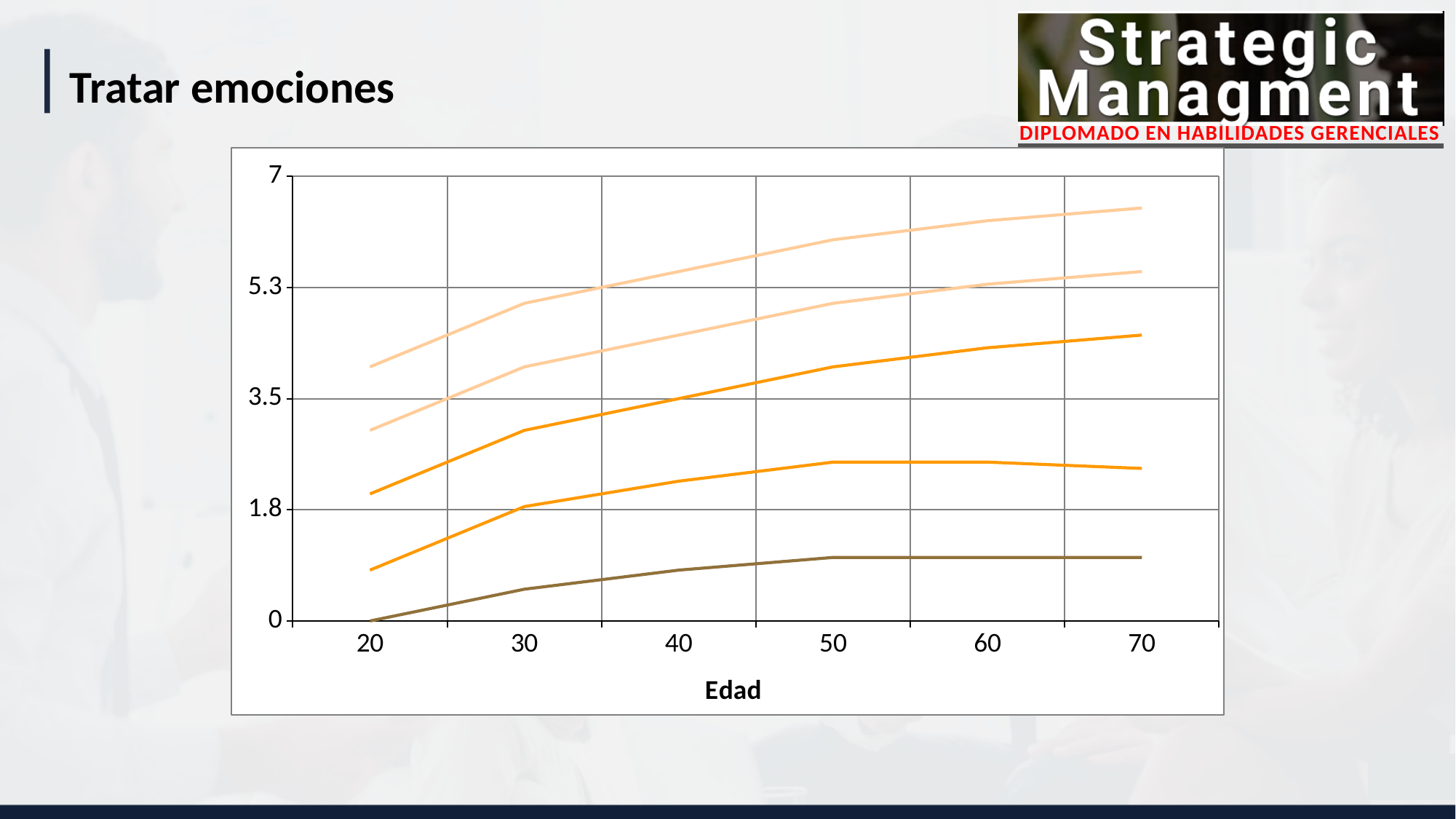
What is the title of the x axis of the chart? Edad Is the value of the second line from the top at age 20 greater or less than 3.5? less What is the highest value shown on the y axis of the chart? 7 At age 70, which is larger: the value of the topmost line or the value of the lowest line? the topmost line What kind of chart is shown on the slide? line chart Is the value of the topmost line at age 20 greater or less than 3.5? greater What is the value of the lowest line at age 20? 0 How many lines are plotted on the chart? 5 How many age values are marked along the x axis of the chart? 6 Is the value of the lowest line at age 70 greater or less than 1.8? less Does the topmost line rise or fall as age increases from 20 to 70? rise